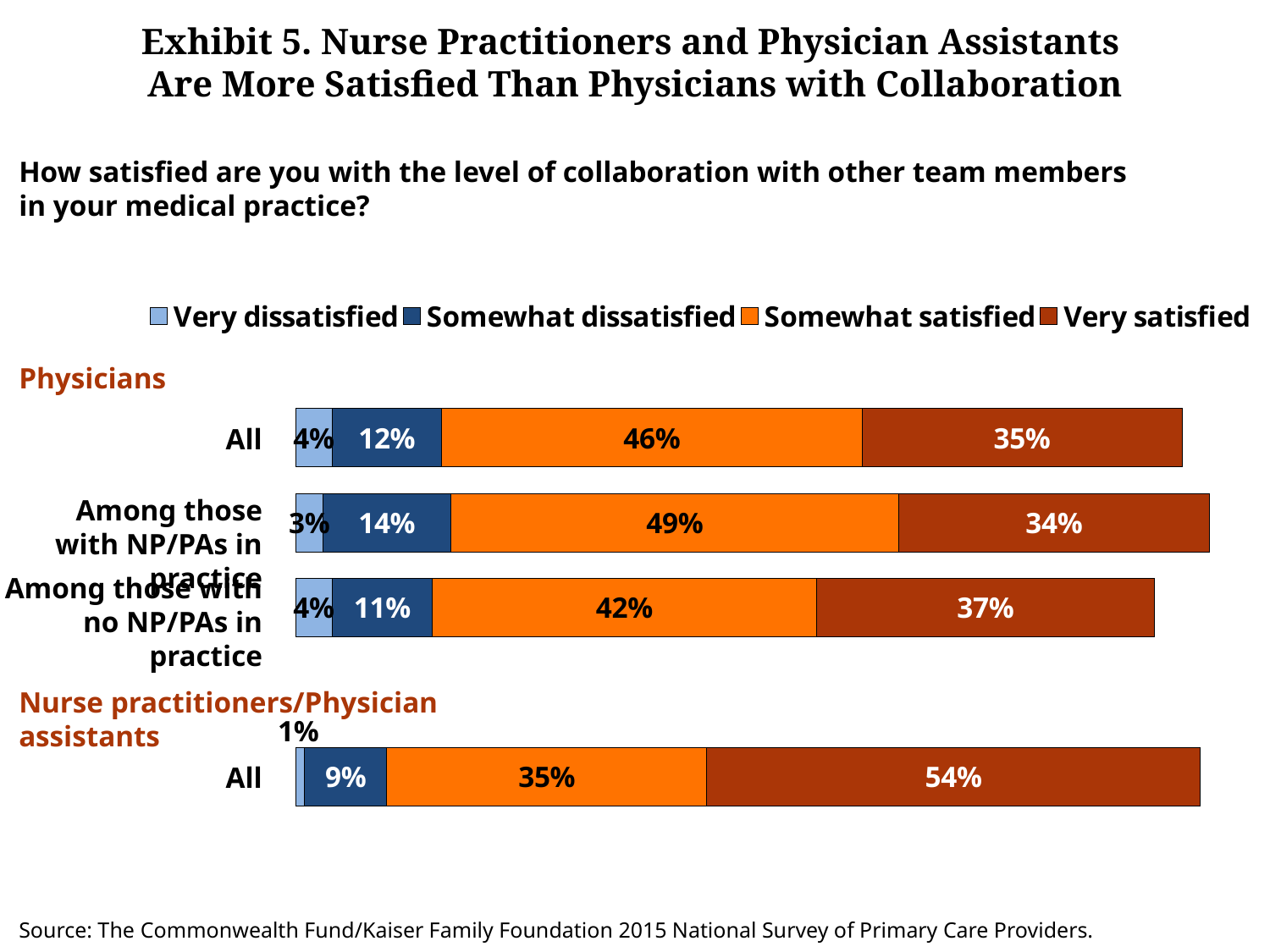
How many series does the legend list? 4 What percentage of physicians with no NP/PAs in practice are somewhat dissatisfied? 11% Which group has the lowest share of respondents who are somewhat satisfied? Nurse practitioners/Physician assistants (All) How many bars are shown in the chart? 4 Which group has the highest share of respondents who are very satisfied? Nurse practitioners/Physician assistants (All) What percentage of all physicians are very satisfied with the level of collaboration? 35% Which is larger: the somewhat dissatisfied share among physicians with NP/PAs in practice or among physicians with no NP/PAs in practice? Among those with NP/PAs in practice What percentage of all nurse practitioners/physician assistants are very satisfied with collaboration? 54% What percentage of all nurse practitioners/physician assistants are very dissatisfied? 1% What is the difference between the very satisfied share for all nurse practitioners/physician assistants and for all physicians? 19 percentage points What percentage of physicians with NP/PAs in practice are somewhat satisfied? 49% What kind of chart is shown on the slide? Stacked bar chart